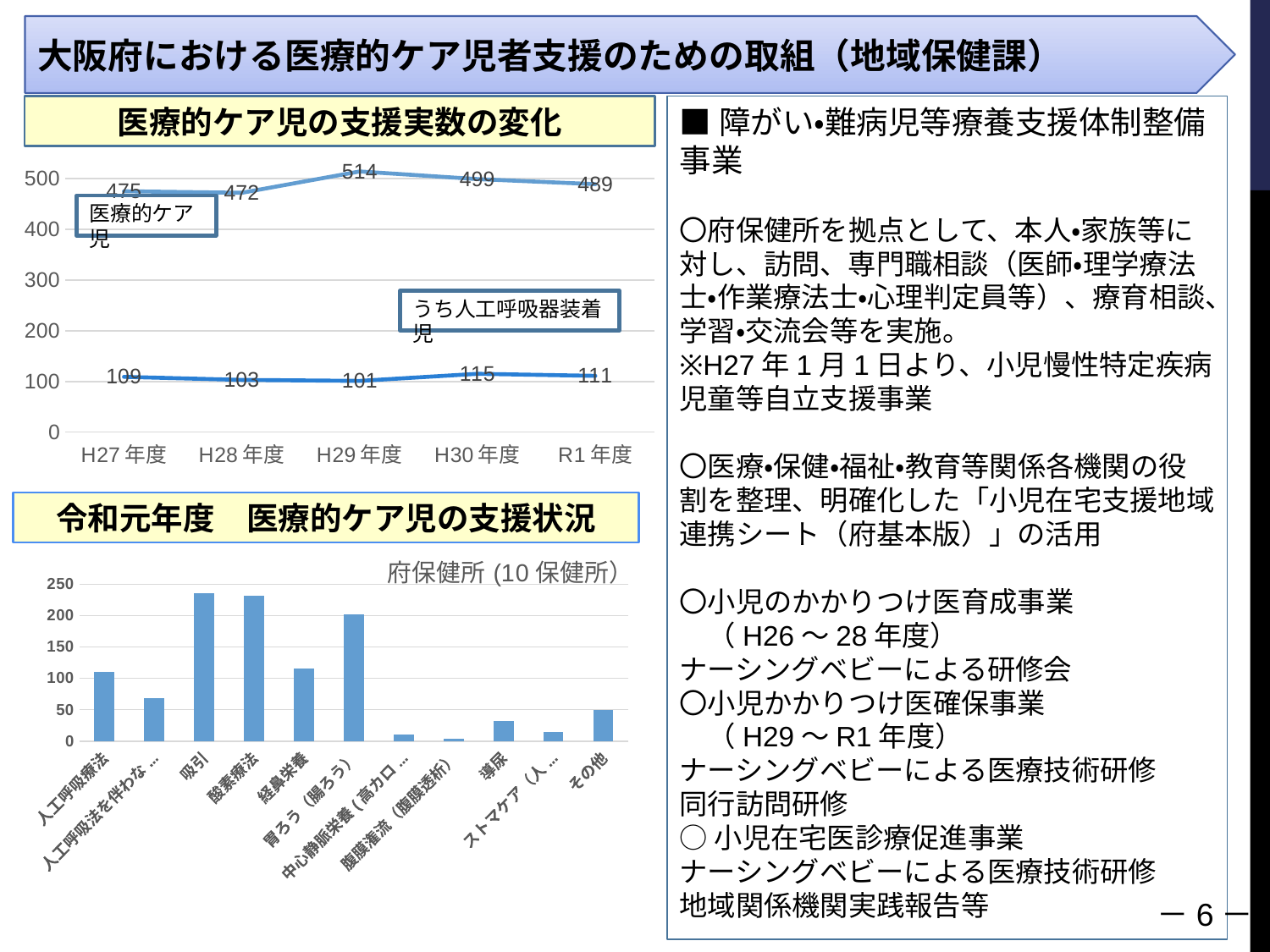
In the line chart 医療的ケア児の支援実数の変化, what is the value for 医療的ケア児 in H29年度? 514 In the line chart 医療的ケア児の支援実数の変化, what is the value for うち人工呼吸器装着児 in H30年度? 115 What kind of chart is 令和元年度 医療的ケア児の支援状況? bar chart In the line chart 医療的ケア児の支援実数の変化, what is the difference between the 医療的ケア児 value and the うち人工呼吸器装着児 value in R1年度? 378 In the line chart 医療的ケア児の支援実数の変化, how many years are shown on the x axis? 5 In the line chart 医療的ケア児の支援実数の変化, in which year is the うち人工呼吸器装着児 value lowest? H29年度 In the line chart 医療的ケア児の支援実数の変化, how many series are plotted? 2 In the bar chart 令和元年度 医療的ケア児の支援状況, is the value for 吸引 greater or less than 200? greater In the line chart 医療的ケア児の支援実数の変化, is the 医療的ケア児 value larger in H27年度 or H28年度? H27年度 In the line chart 医療的ケア児の支援実数の変化, in which year is the 医療的ケア児 value highest? H29年度 In the bar chart 令和元年度 医療的ケア児の支援状況, how many categories are shown? 11 In the bar chart 令和元年度 医療的ケア児の支援状況, is the value for 導尿 greater or less than 50? less